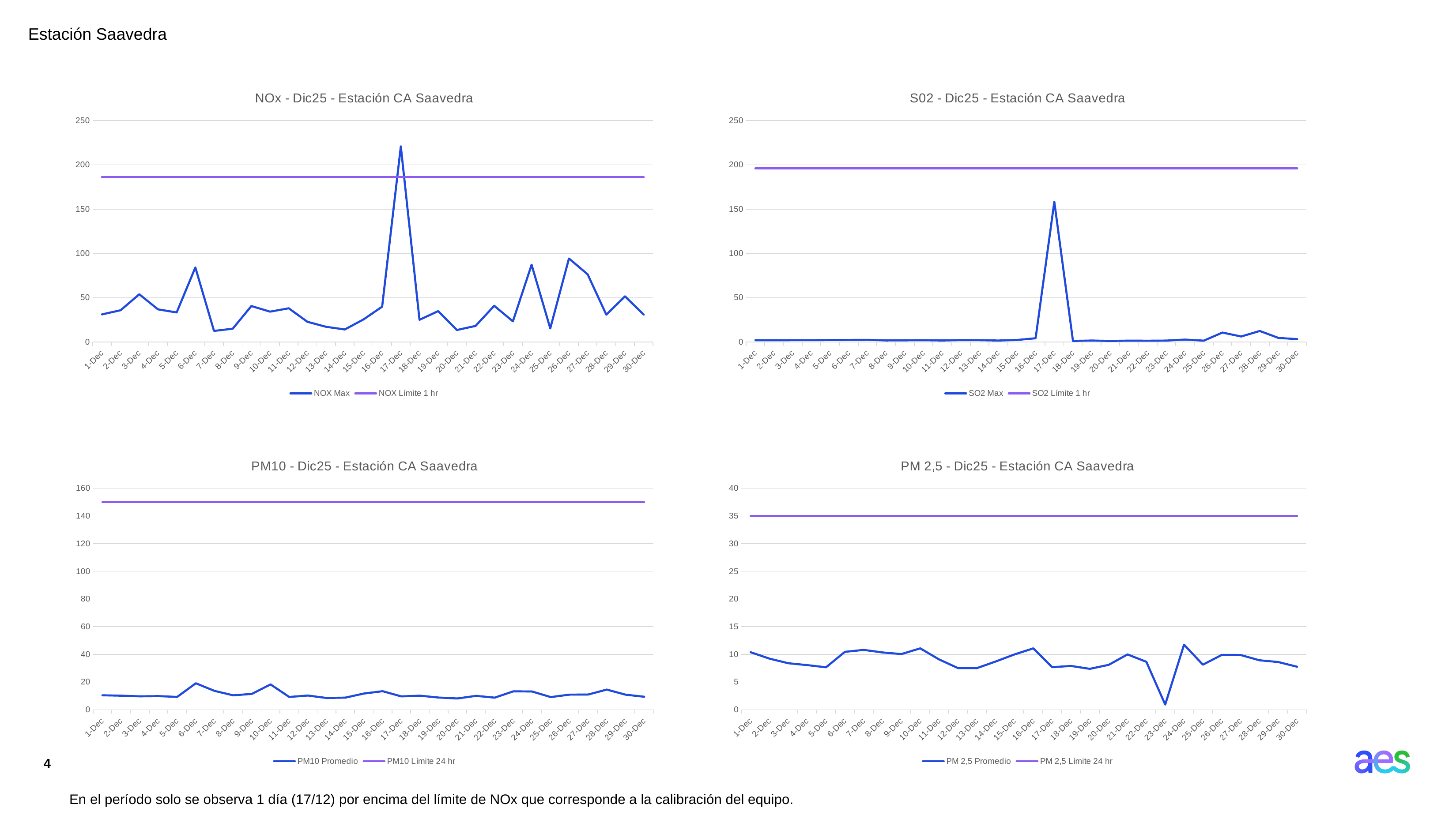
What kind of chart is the 'NOx - Dic25 - Estación CA Saavedra' chart? line chart In the 'PM 2,5 - Dic25 - Estación CA Saavedra' chart, on which date does PM 2,5 Promedio reach its lowest value? 23-Dec In the 'PM 2,5 - Dic25 - Estación CA Saavedra' chart, what is the value of the PM 2,5 Límite 24 hr line? 35 In the 'NOx - Dic25 - Estación CA Saavedra' chart, on which date does NOX Max reach its highest value? 17-Dec How many dates are plotted along the x axis of the 'PM10 - Dic25 - Estación CA Saavedra' chart? 30 How many series does the legend of the 'S02 - Dic25 - Estación CA Saavedra' chart list? 2 What are the two legend entries of the 'PM10 - Dic25 - Estación CA Saavedra' chart? PM10 Promedio and PM10 Límite 24 hr In the 'S02 - Dic25 - Estación CA Saavedra' chart, on which date does SO2 Max reach its highest value? 17-Dec In the 'NOx - Dic25 - Estación CA Saavedra' chart, is the NOX Max value on 17-Dec greater or less than 200? greater In the 'S02 - Dic25 - Estación CA Saavedra' chart, is the SO2 Max value on 17-Dec greater or less than 150? greater In the 'PM 2,5 - Dic25 - Estación CA Saavedra' chart, which is larger: the PM 2,5 Promedio value on 24-Dec or on 23-Dec? 24-Dec In the 'PM10 - Dic25 - Estación CA Saavedra' chart, is the PM10 Promedio value on 6-Dec greater or less than 40? less